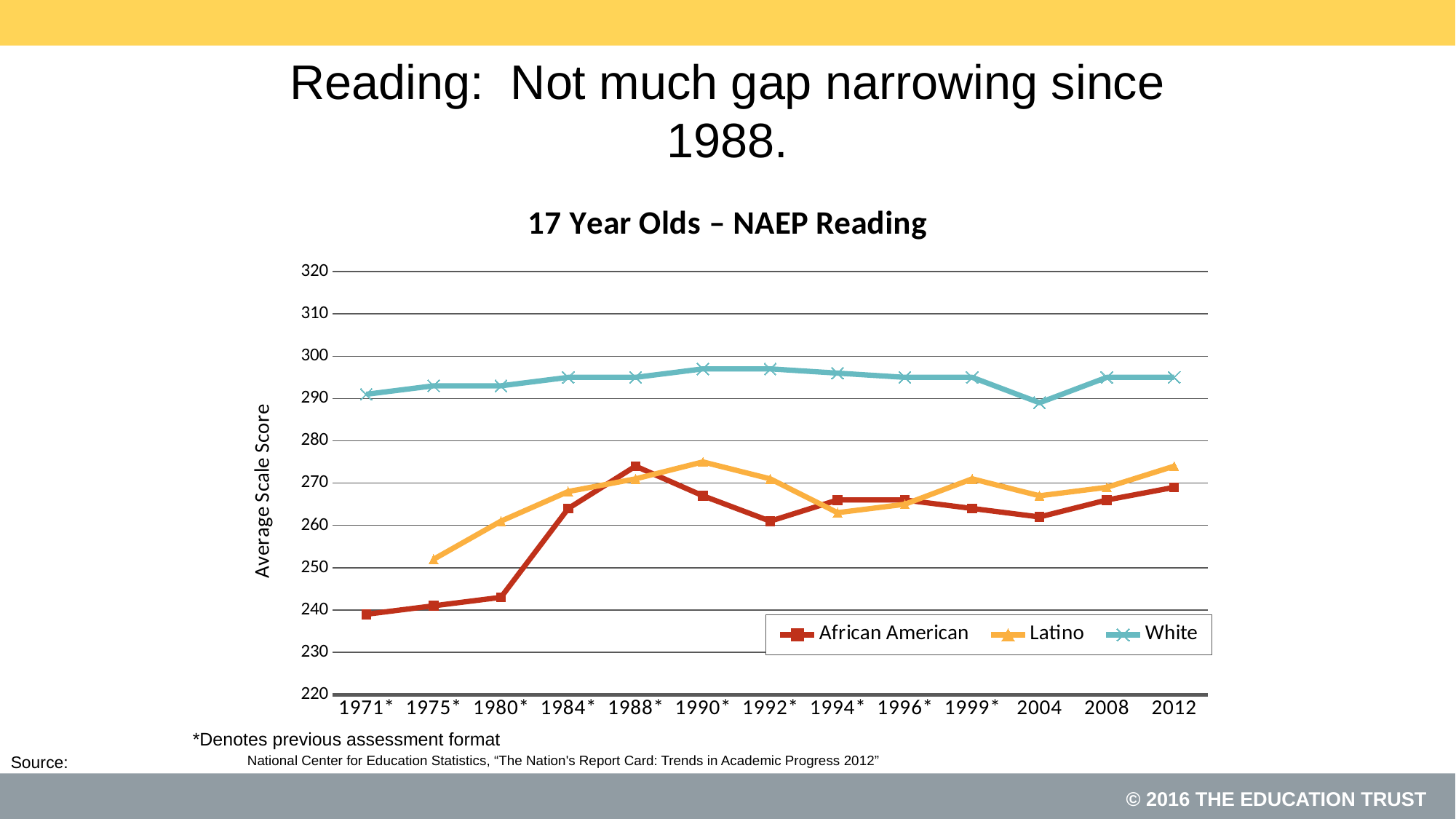
What kind of chart is shown on the slide? line chart Is the value for White in 1990* greater or less than 290? greater How many assessment years are plotted along the x axis? 13 Is the value for African American in 1971* greater or less than 250? less How many series does the legend list? 3 Which series has the highest values throughout the chart? White In 1990*, which is larger, the Latino value or the African American value? Latino Does the African American series rise or fall from 1971* to 1988*? rise In which year is the White series at its lowest value? 2004 In which year is the African American series at its lowest value? 1971* In which year does the African American series reach its highest value? 1988* Is the value for Latino in 1975* greater or less than 260? less